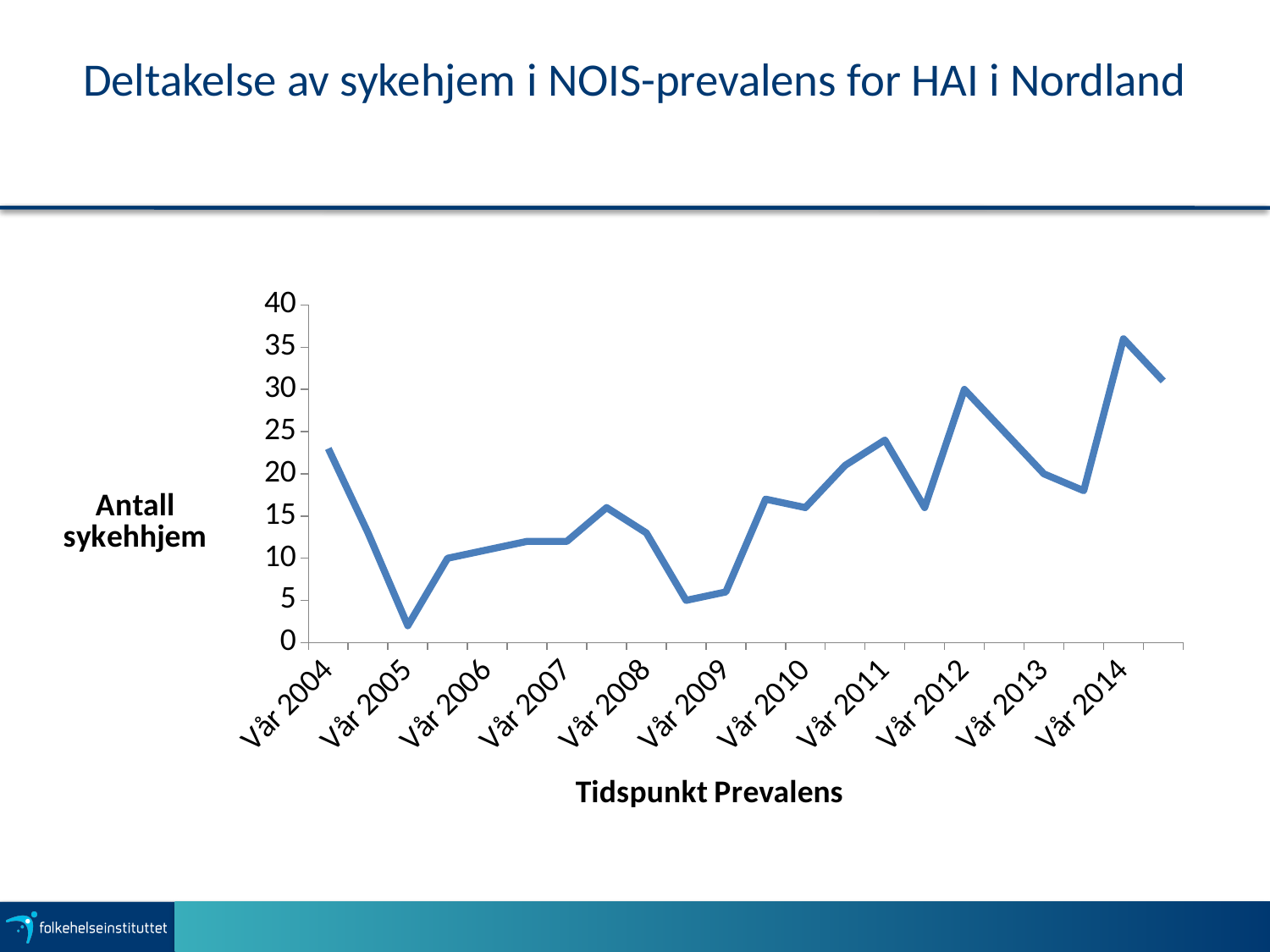
Which labelled time point has the lowest number of nursing homes? Vår 2005 How many time points are labelled on the x axis? 11 Is the value for Vår 2009 greater or less than 10? less Is the value for Vår 2004 greater or less than 20? greater What is the title of the x axis? Tidspunkt Prevalens Which labelled time point has the highest number of nursing homes? Vår 2014 What kind of chart is shown on the slide? line chart Which is larger, the value for Vår 2004 or the value for Vår 2005? Vår 2004 Is the value for Vår 2011 greater or less than 20? greater Which is larger, the value for Vår 2014 or the value for Vår 2012? Vår 2014